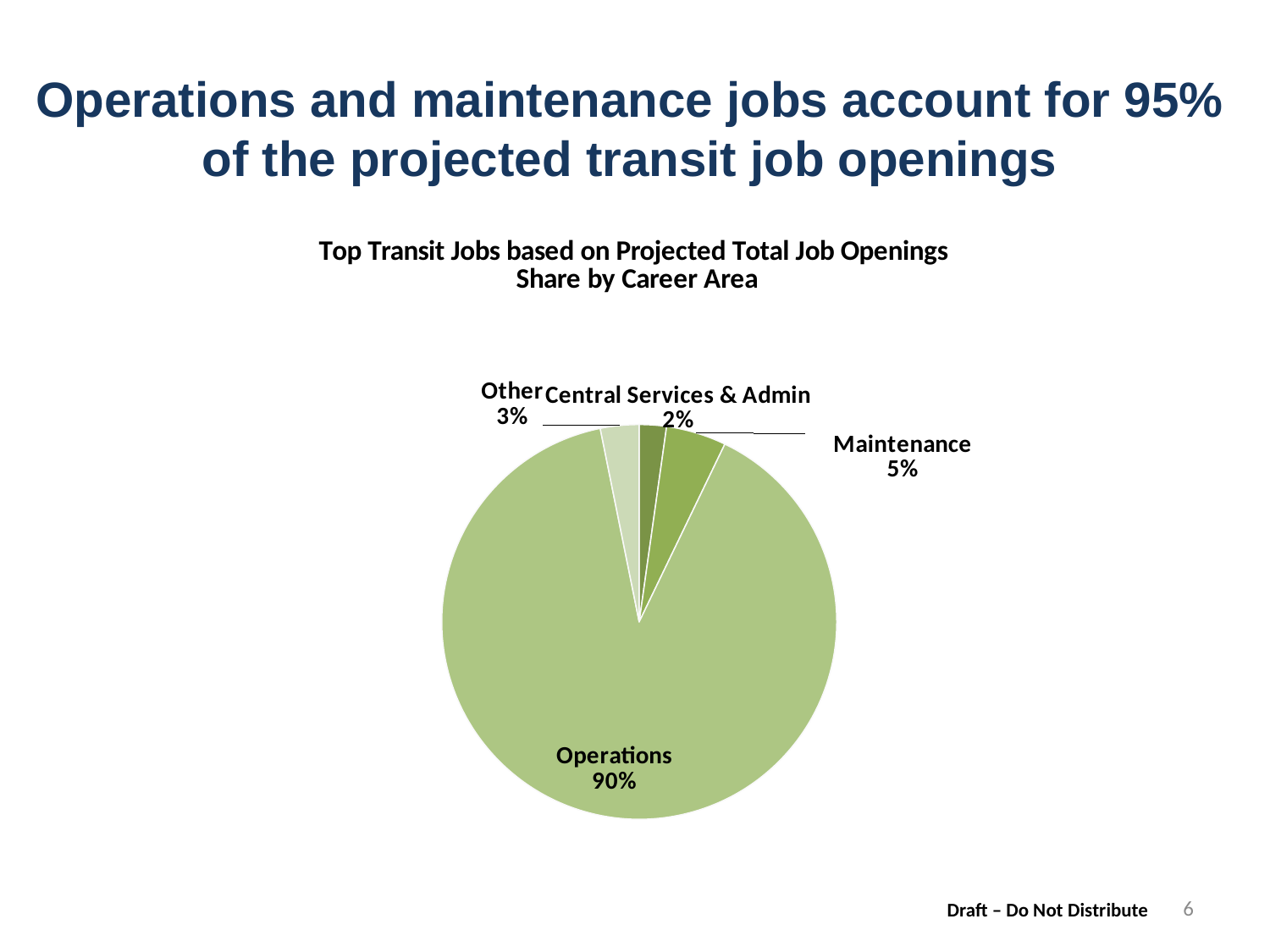
What share of the pie does Central Services & Admin account for? 2% What share of the pie does Operations account for? 90% Which career area has the largest share of projected job openings? Operations Which career area has the smallest share of projected job openings? Central Services & Admin What kind of chart is shown on the slide? Pie chart What is the combined share of Operations and Maintenance? 95% What is the difference in percentage points between the Operations and Maintenance shares? 85 Which has a larger share, Maintenance or Other? Maintenance What is the title of the chart? Top Transit Jobs based on Projected Total Job Openings Share by Career Area What share of the pie does Other account for? 3% How many career areas are shown in the pie chart? 4